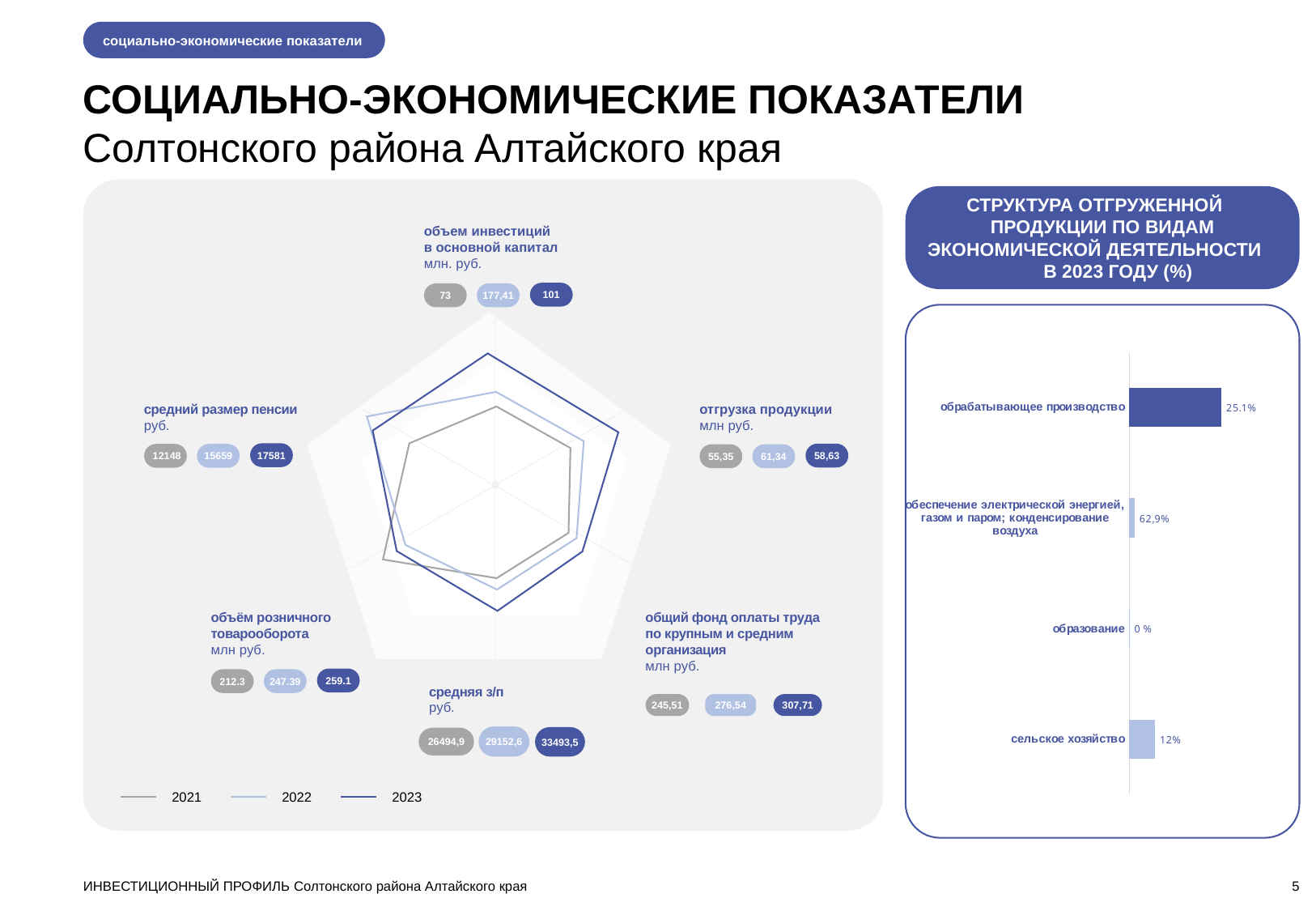
On the radar chart on the left, which year has the larger value for 'отгрузка продукции': 2022 or 2023? 2022 On the radar chart on the left, what is the value of 'средняя з/п' for 2023? 33493,5 On the chart on the right titled 'Структура отгруженной продукции по видам экономической деятельности в 2023 году (%)', what is the value for 'обрабатывающее производство'? 25.1% On the radar chart on the left, what is the value of 'общий фонд оплаты труда по крупным и средним организация' for 2022? 276,54 On the radar chart on the left, what is the value of 'объем инвестиций в основной капитал' for 2023? 101 On the chart on the right titled 'Структура отгруженной продукции по видам экономической деятельности в 2023 году (%)', what is the value for 'сельское хозяйство'? 12% On the radar chart on the left, by how much did 'средний размер пенсии' increase from 2021 to 2023? 5433 On the radar chart on the left, how many indicators (axes) are plotted? 6 On the radar chart on the left, how many series does the legend list? 3 What kind of chart is the chart on the right titled 'Структура отгруженной продукции по видам экономической деятельности в 2023 году (%)'? bar chart On the radar chart on the left, does 'объём розничного товарооборота' rise or fall from 2021 to 2023? rise On the radar chart on the left, what is the value of 'средний размер пенсии' for 2021? 12148